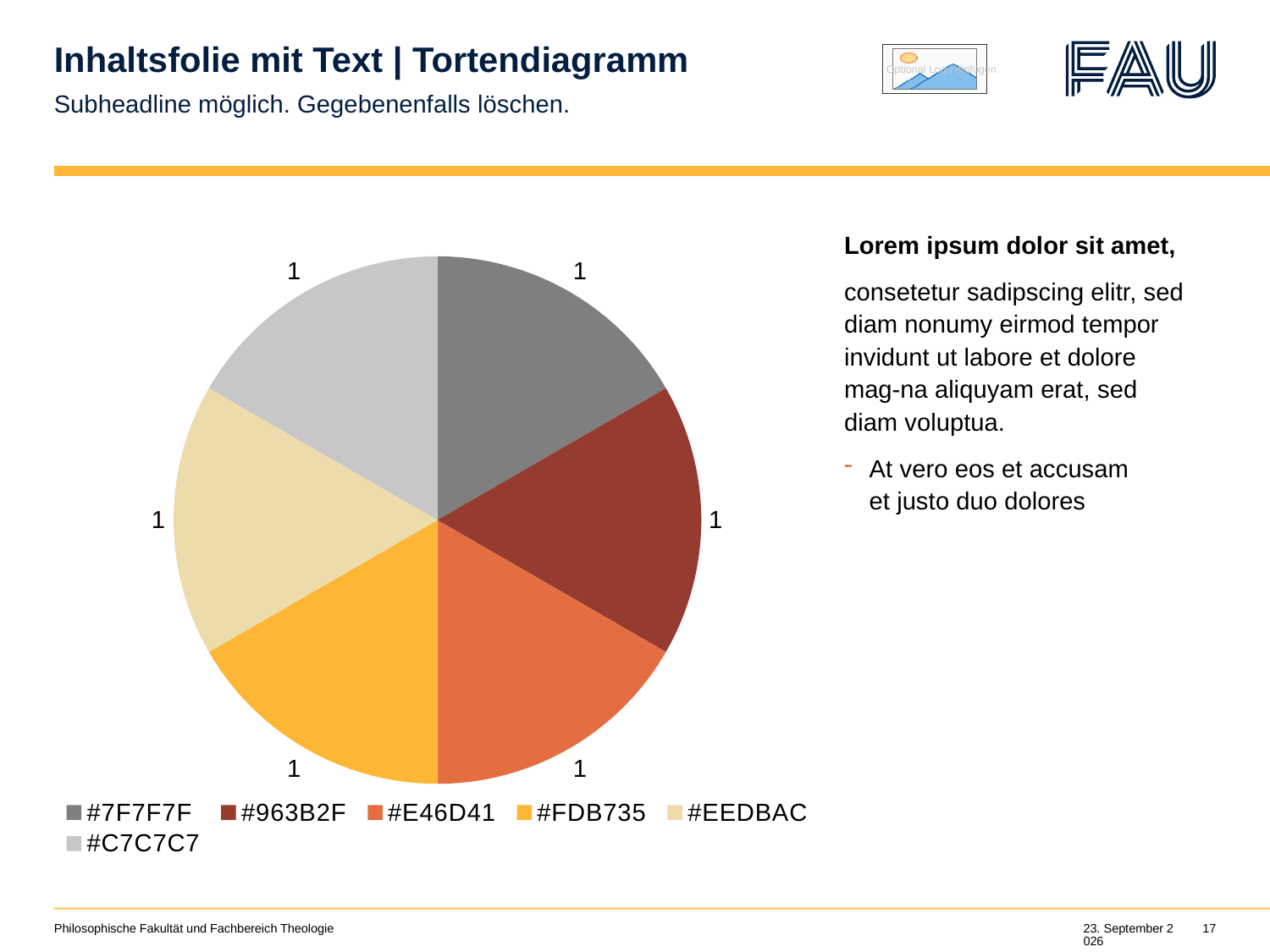
Which legend entry is listed first in the pie chart's legend? #7F7F7F What kind of chart is shown on the slide? pie chart Are all slices of the pie chart the same size? yes Which legend entry is listed last in the pie chart's legend? #C7C7C7 How many entries does the legend of the pie chart list? 6 What is the difference between the values of the #963B2F and #E46D41 slices? 0 What is the value of the #FDB735 slice in the pie chart? 1 What is the total of all slice values in the pie chart? 6 What share of the pie does the #EEDBAC slice represent? 1/6 What is the value of the #C7C7C7 slice in the pie chart? 1 What is the value of the #7F7F7F slice in the pie chart? 1 How many slices does the pie chart have? 6